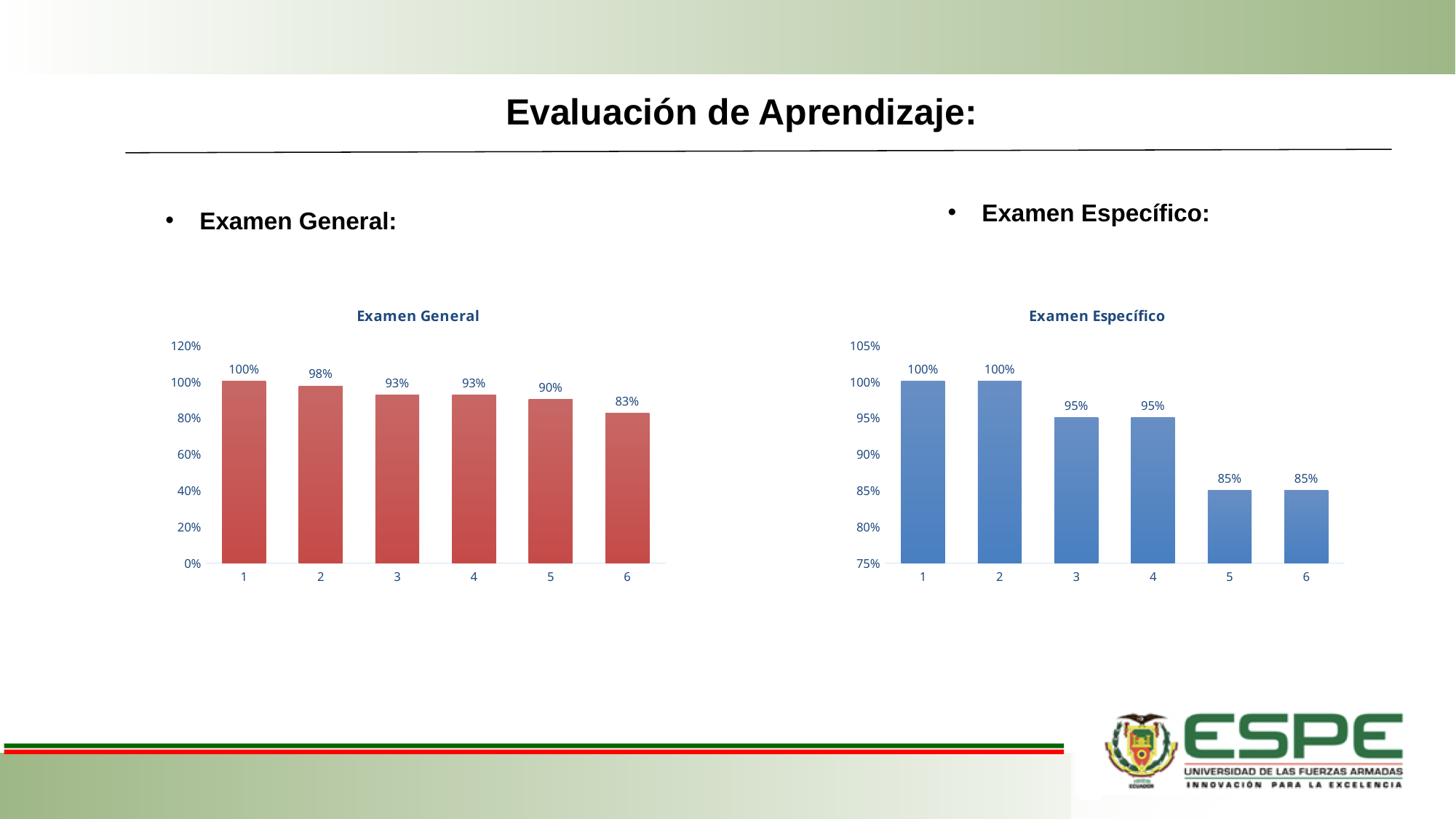
In the Examen General chart, what is the value for category 2? 98% What type of chart is the Examen Específico chart? bar chart In the Examen General chart, do the values rise or fall from category 1 to category 6? fall In the Examen General chart, how many bars are plotted? 6 In the Examen General chart, what is the value for category 6? 83% In the Examen Específico chart, what is the difference between the values for category 2 and category 6? 15% In the Examen Específico chart, what is the value for category 3? 95% In the Examen Específico chart, is the value for category 4 larger or smaller than the value for category 5? larger In the Examen Específico chart, what is the value for category 5? 85% In the Examen General chart, which category has the highest value? 1 In the Examen General chart, what is the difference between the values for category 1 and category 5? 10% In the Examen General chart, which category has the lowest value? 6